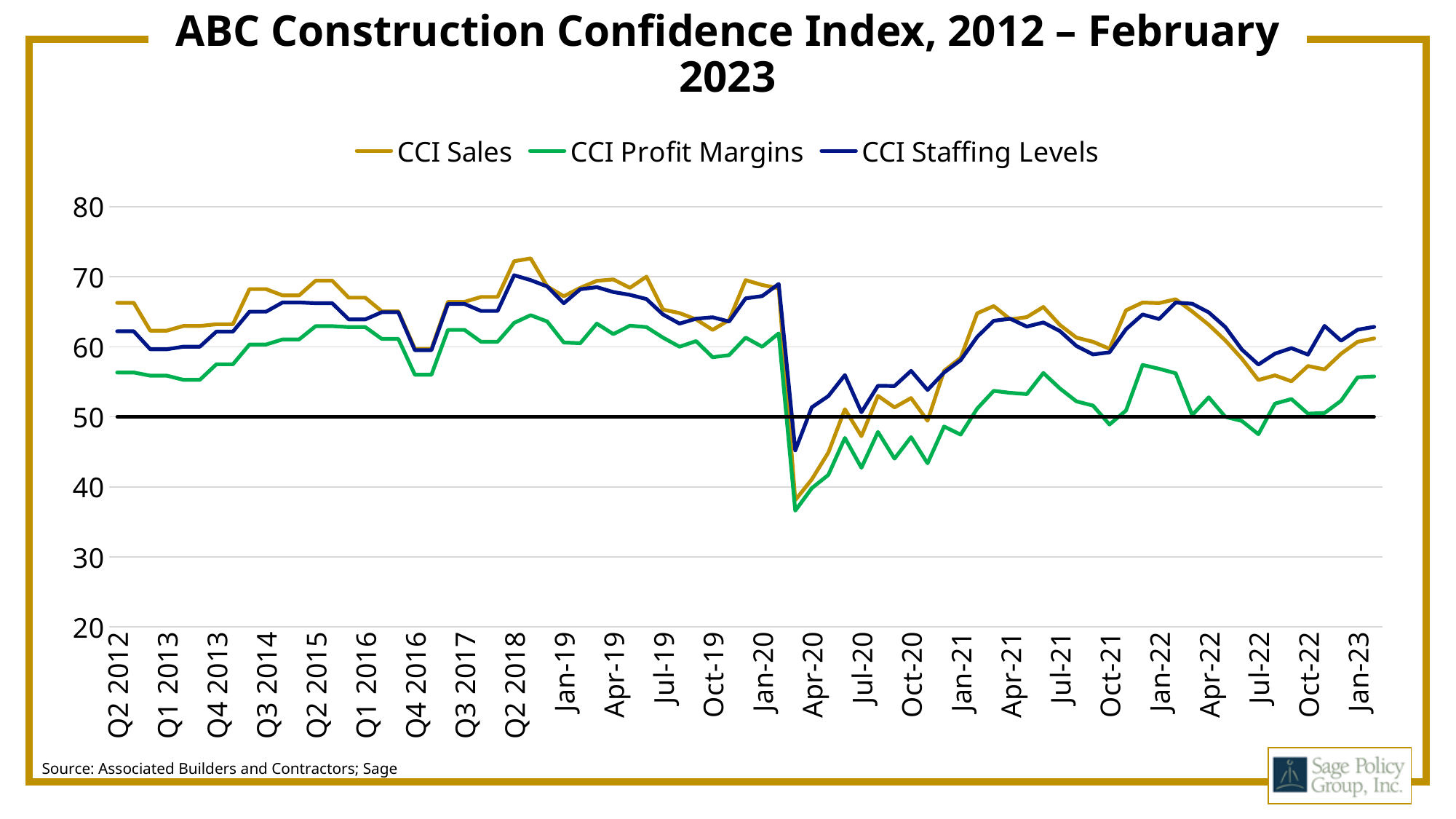
How many series does the legend list? 3 What is the title of the chart? ABC Construction Confidence Index, 2012 – February 2023 Which series has the lowest value at Apr-20? CCI Profit Margins Is the value for CCI Sales at Q2 2015 greater or less than 60? greater What are the three series named in the legend? CCI Sales, CCI Profit Margins, CCI Staffing Levels What kind of chart is shown on the slide? Line chart Is the value for CCI Profit Margins at Q2 2012 greater or less than 50? greater Is the value for CCI Profit Margins at Apr-20 greater or less than 50? less At Q2 2012, which is larger: CCI Sales or CCI Profit Margins? CCI Sales Does CCI Profit Margins rise or fall between Jan-20 and Apr-20? Fall